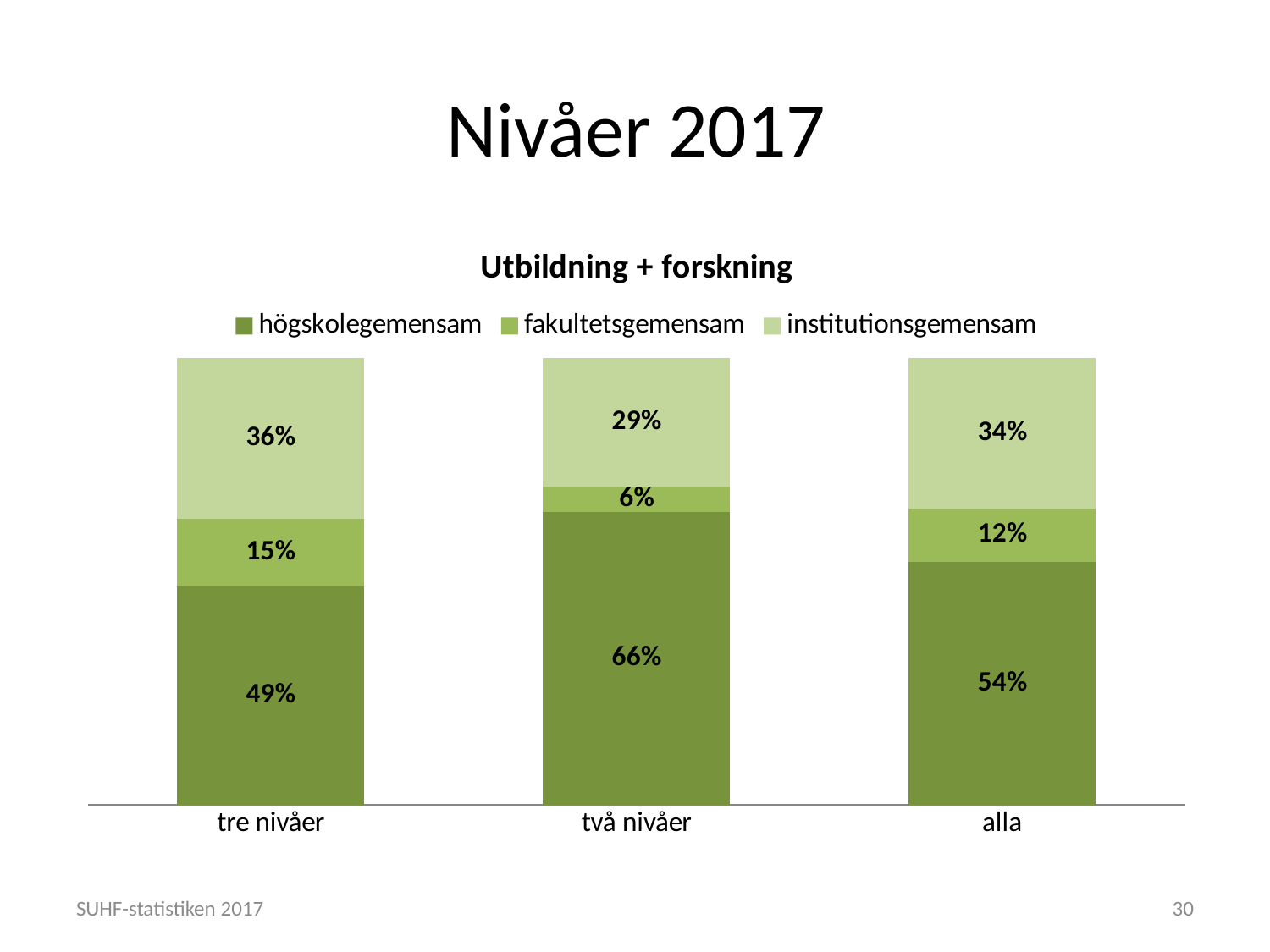
Which is larger: institutionsgemensam for tre nivåer or for två nivåer? tre nivåer What is the title of the chart? Utbildning + forskning What is the value for institutionsgemensam in the alla bar? 34% Which category has the lowest value for fakultetsgemensam? två nivåer What is the value for högskolegemensam in the tre nivåer bar? 49% How many categories are shown on the x axis? 3 What is the value for fakultetsgemensam in the två nivåer bar? 6% What is the difference between the högskolegemensam values for två nivåer and tre nivåer? 17% Which category has the highest value for högskolegemensam? två nivåer What is the value for fakultetsgemensam in the alla bar? 12% How many series does the legend list? 3 What kind of chart is shown? stacked bar chart